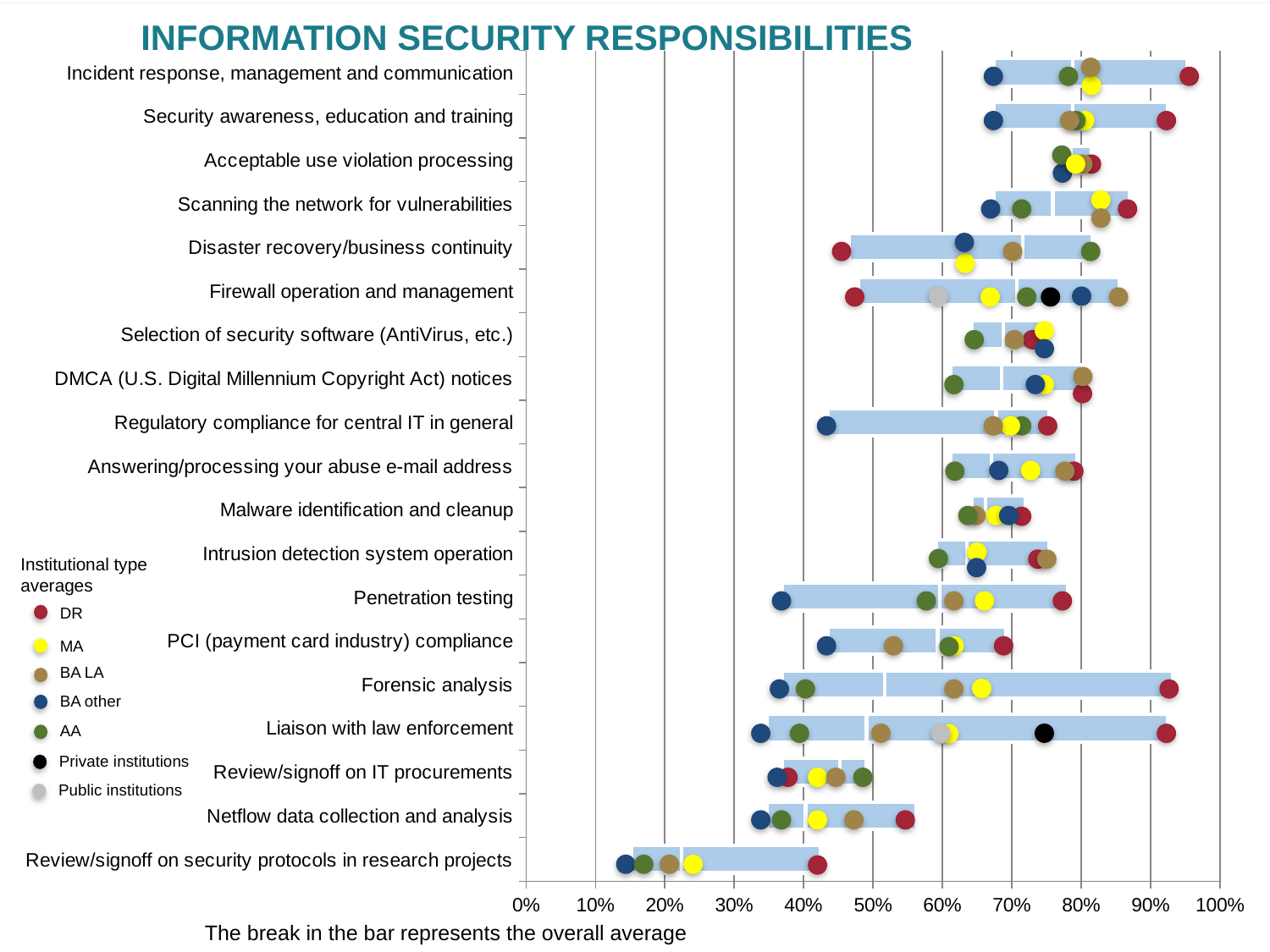
Is the BA other value for Review/signoff on security protocols in research projects greater or less than 20%? less Is the Private institutions value for Liaison with law enforcement greater or less than 70%? greater Is the BA other value for Regulatory compliance for central IT in general greater or less than 50%? less What kind of chart is this? Horizontal bar chart with dot markers For Incident response, management and communication, which is larger: the DR value or the BA other value? DR Which category has the lowest BA other value? Review/signoff on security protocols in research projects What is the title of the chart? INFORMATION SECURITY RESPONSIBILITIES How many institutional types does the legend list? 7 According to the note below the chart, what does the break in each bar represent? The overall average How many responsibility categories are plotted on the chart? 19